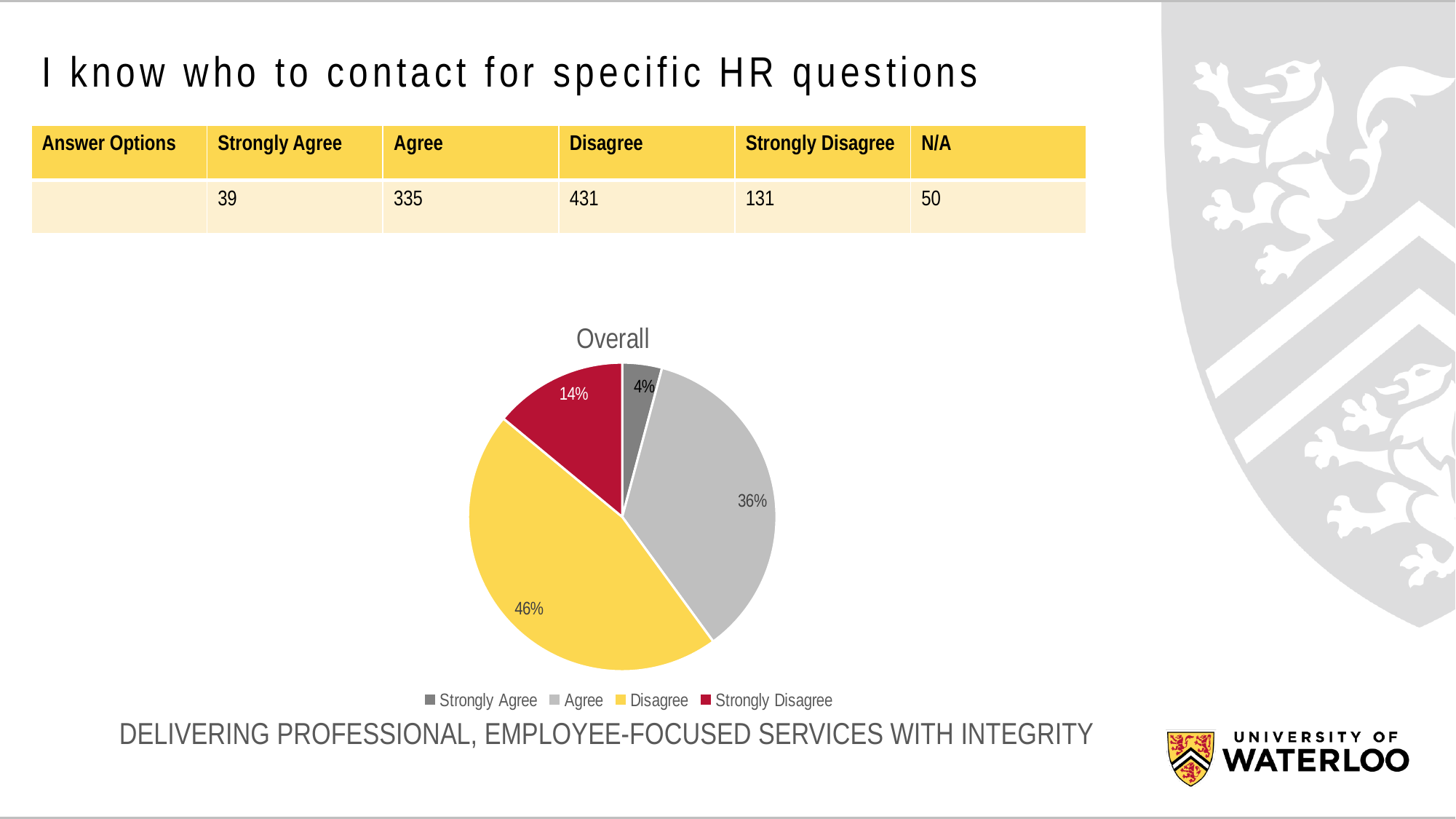
How many entries does the legend list? 4 How many slices does the pie chart have? 4 What share of the pie does Strongly Agree take? 4% What share of the pie does Agree take? 36% Which category has the smallest slice of the pie? Strongly Agree What kind of chart is shown on the slide? pie chart What share of the pie does Disagree take? 46% Which category has the largest slice of the pie? Disagree What is the title of the pie chart? Overall Which slice is larger, Strongly Disagree or Strongly Agree? Strongly Disagree What is the difference in percentage points between the Disagree and Agree slices? 10